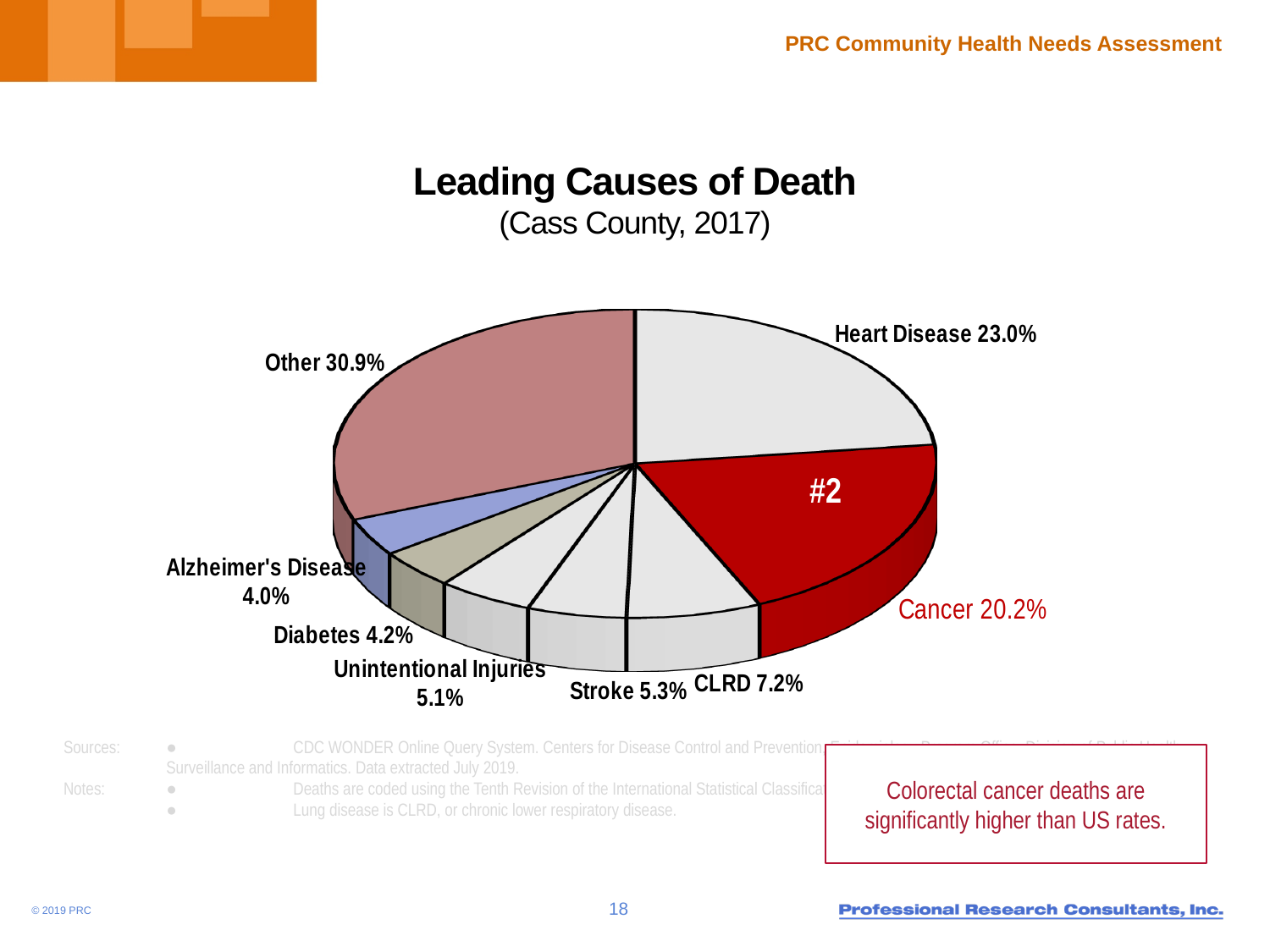
What percentage is shown for CLRD? 7.2% What is the value shown for Cancer? 20.2% How many slices does the pie chart have? 8 What percentage of deaths is attributed to Heart Disease? 23.0% What share of the pie does Other represent? 30.9% What is the difference in percentage points between Heart Disease and Cancer? 2.8 Which slice of the pie is the largest? Other Which slice is labeled "#2" on the chart? Cancer What is the value for Unintentional Injuries? 5.1% What kind of chart is shown on the slide? pie chart Which is larger, the share for Stroke or the share for Diabetes? Stroke Which named cause of death has the smallest slice? Alzheimer's Disease